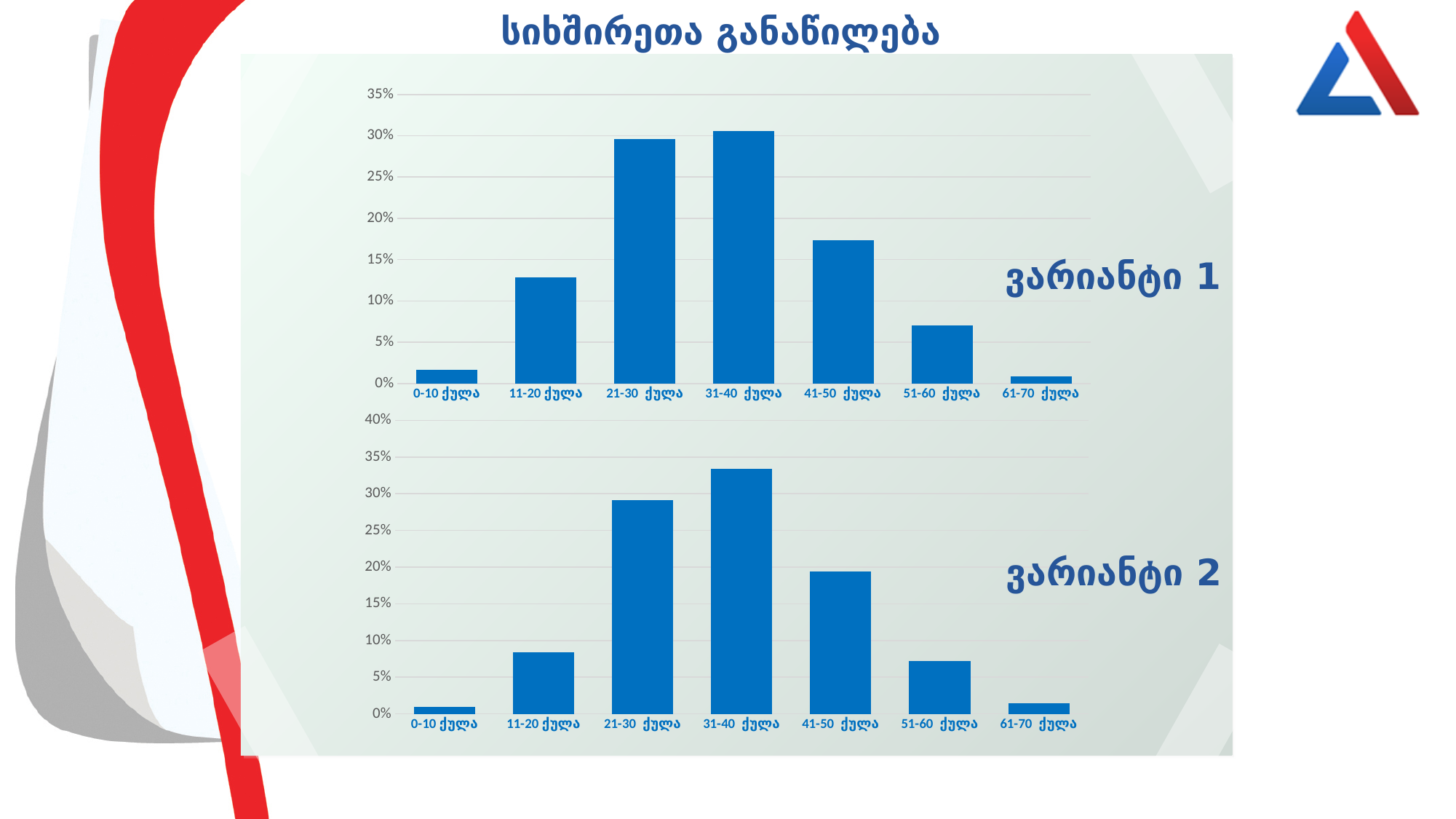
How many categories are shown on the x axis of the bottom chart (ვარიანტი 2)? 7 In the bottom chart (ვარიანტი 2), which is larger: the value for 21-30 ქულა or the value for 41-50 ქულა? 21-30 ქულა In the top chart (ვარიანტი 1), is the value for 41-50 ქულა greater or less than 20%? less In the bottom chart (ვარიანტი 2), is the value for 11-20 ქულა greater or less than 10%? less What kind of chart is the top chart (ვარიანტი 1)? bar chart What is the title shown above the charts on the slide? სიხშირეთა განაწილება In the top chart (ვარიანტი 1), which is larger: the value for 41-50 ქულა or the value for 51-60 ქულა? 41-50 ქულა In the bottom chart (ვარიანტი 2), which category has the highest value? 31-40 ქულა What is the highest tick value on the y axis of the bottom chart (ვარიანტი 2)? 40% In the top chart (ვარიანტი 1), do the values rise or fall from 31-40 ქულა to 61-70 ქულა? fall In the bottom chart (ვარიანტი 2), is the value for 31-40 ქულა greater or less than 30%? greater